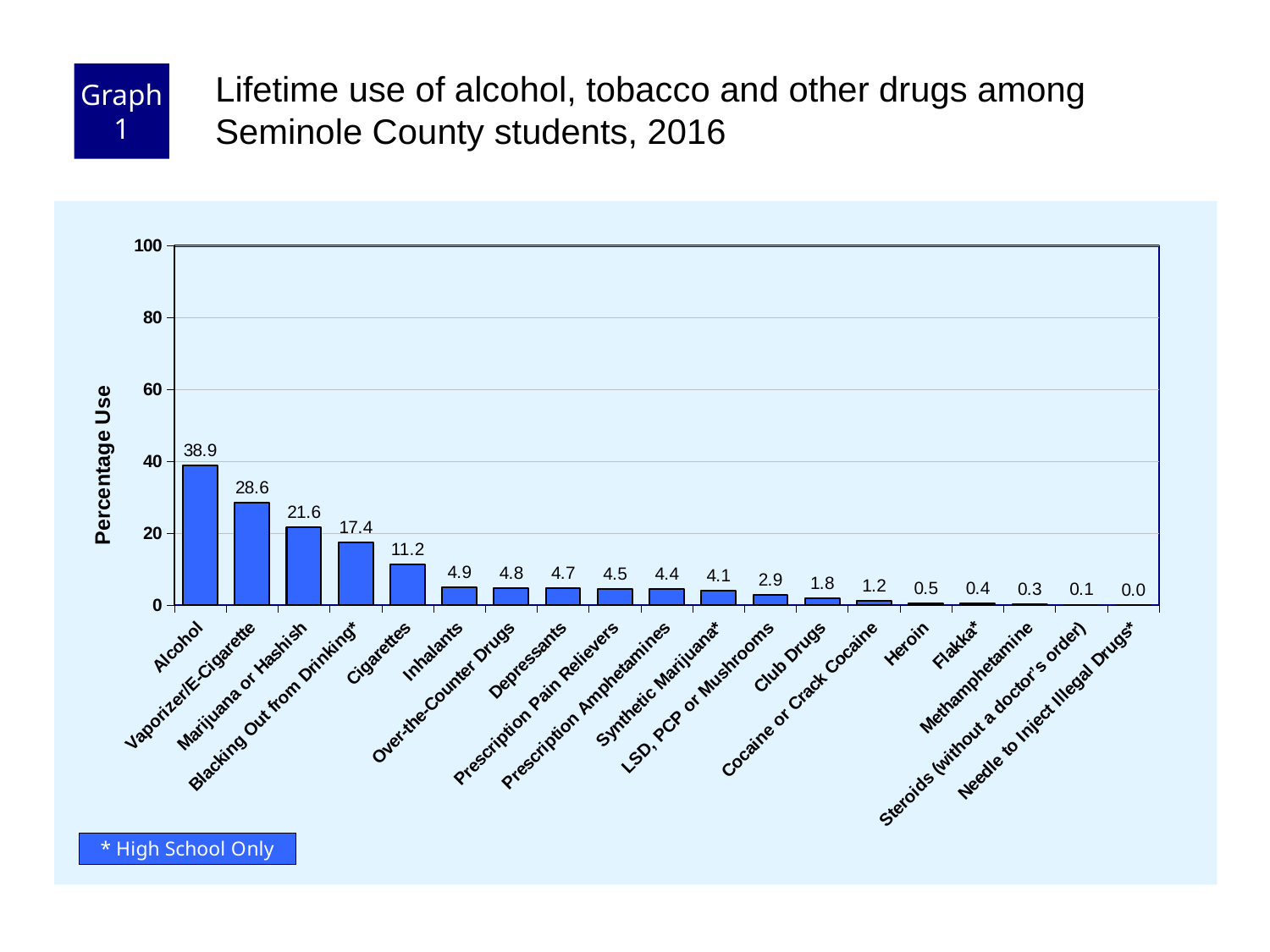
What kind of chart is shown on the slide? bar chart Which category has the highest percentage use? Alcohol What is the percentage use for Alcohol? 38.9 What is the percentage use for Heroin? 0.5 Which category has the lowest percentage use? Needle to Inject Illegal Drugs* What is the percentage use for Cigarettes? 11.2 Which has a higher percentage use, Marijuana or Hashish or Cigarettes? Marijuana or Hashish What is the difference in percentage use between Alcohol and Vaporizer/E-Cigarette? 10.3 Is the value for Blacking Out from Drinking* greater or less than 20? less Do the values rise or fall moving from left to right along the x axis? fall How many categories are shown on the x axis? 19 What is the label on the y axis? Percentage Use